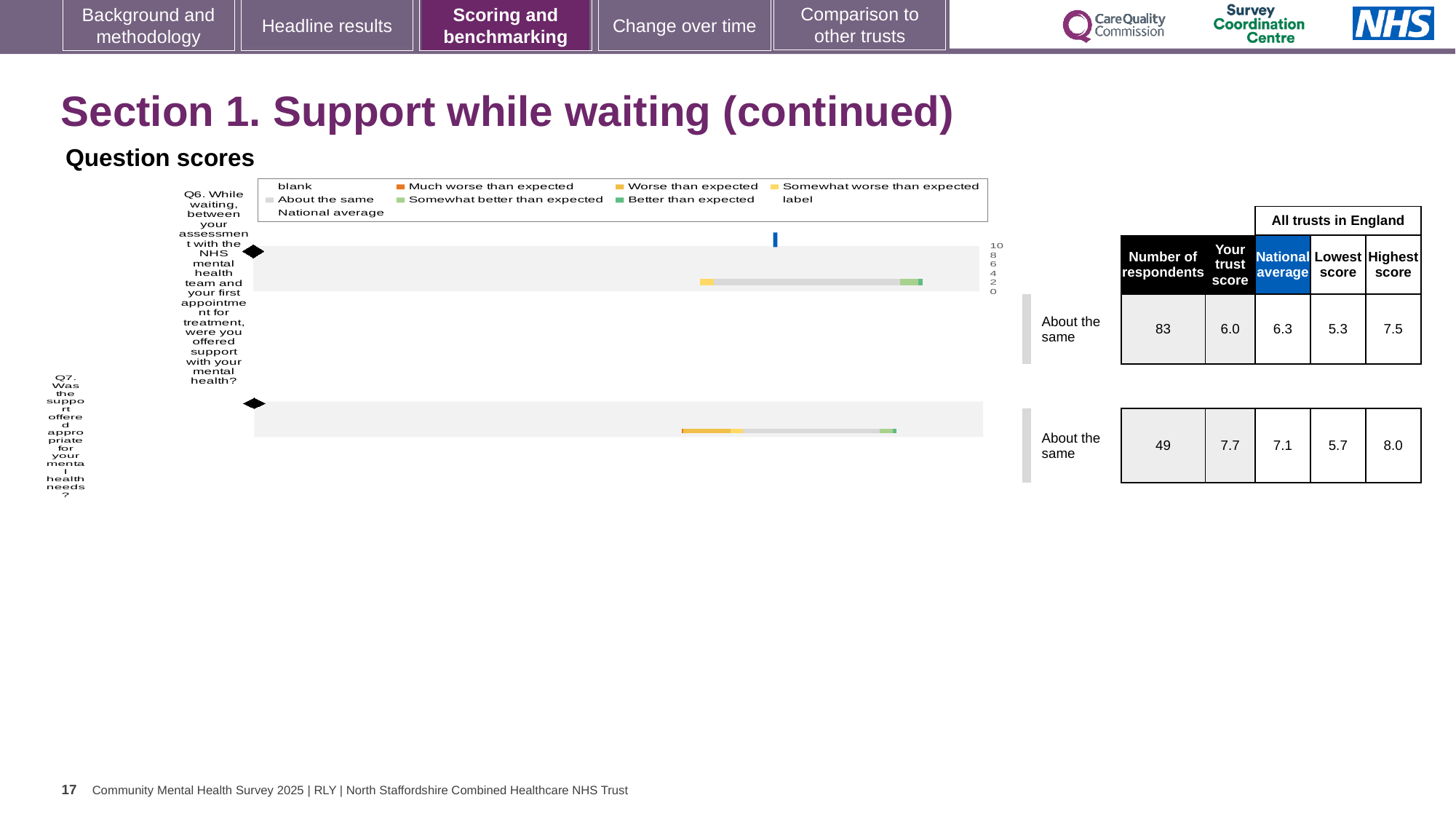
For Q7, what is the difference between the highest score and the lowest score among all trusts in England? 2.3 What benchmark category is shown for Q7? About the same How many questions (bars) are plotted on the slide? 2 For Q7, what is the national average score? 7.1 For Q6, what is the difference between the highest score and the lowest score among all trusts in England? 2.2 For Q7, which is larger: the trust's score or the national average? trust score For Q7, what is the highest score among all trusts in England? 8.0 How many entries does the chart legend list? 9 What kind of chart is used to show the question scores for Q6 and Q7? bar chart For Q6, what is the number of respondents shown? 83 For Q6, which is larger: the trust's score or the national average? national average For Q6, what is the trust's score? 6.0